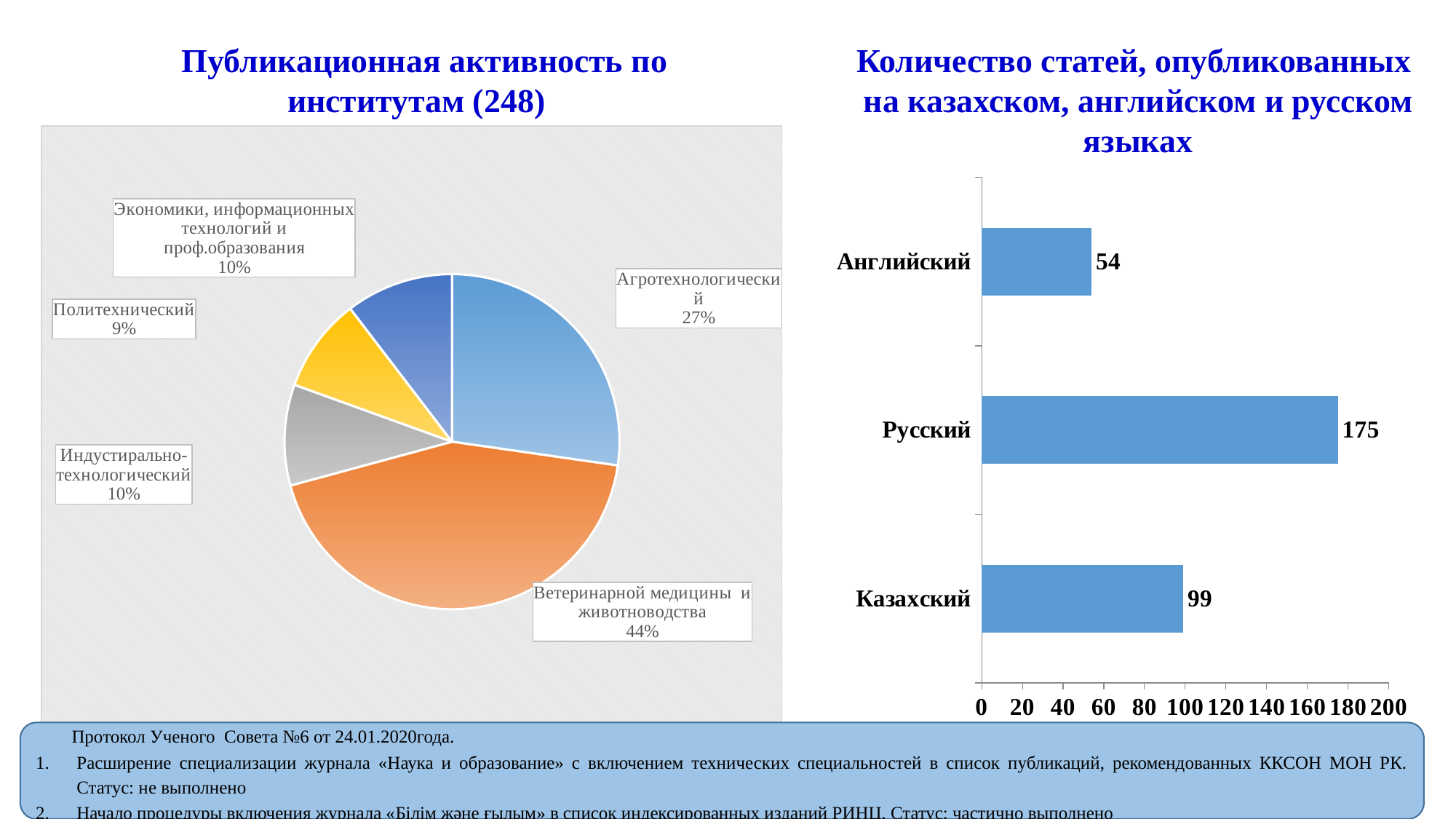
In the chart 'Количество статей, опубликованных на казахском, английском и русском языках', what is the value for 'Английский'? 54 In the chart 'Количество статей, опубликованных на казахском, английском и русском языках', is the value for 'Казахский' greater or less than 100? less In the chart 'Публикационная активность по институтам (248)', what share does 'Агротехнологический' have? 27% In the chart 'Количество статей, опубликованных на казахском, английском и русском языках', which language has the lowest value? Английский In the chart 'Количество статей, опубликованных на казахском, английском и русском языках', what is the difference between 'Русский' and 'Казахский'? 76 In the chart 'Публикационная активность по институтам (248)', which institute has the largest slice? Ветеринарной медицины и животноводства In the chart 'Публикационная активность по институтам (248)', how many slices does the pie have? 5 In the chart 'Публикационная активность по институтам (248)', what share does 'Ветеринарной медицины и животноводства' have? 44% In the chart 'Количество статей, опубликованных на казахском, английском и русском языках', what is the value for 'Русский'? 175 In the chart 'Публикационная активность по институтам (248)', which institute has the smallest slice? Политехнический What kind of chart is 'Количество статей, опубликованных на казахском, английском и русском языках'? Bar chart What kind of chart is 'Публикационная активность по институтам (248)'? Pie chart